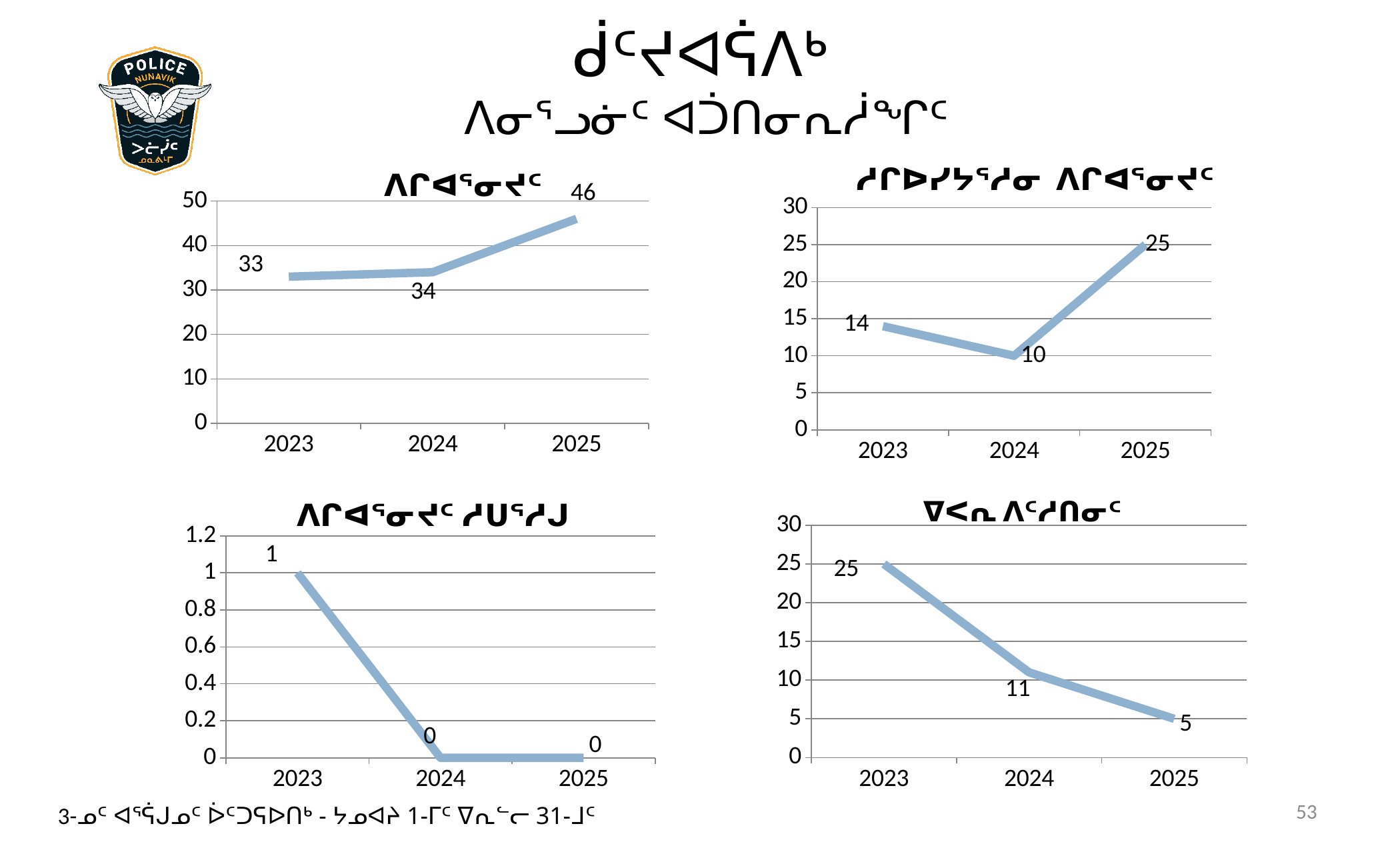
In the top-left chart, do the values rise or fall from 2023 to 2025? rise In the top-left chart, what is the value for 2025? 46 What kind of chart is the top-right chart? line chart In the top-right chart, which year has the lowest value? 2024 In the top-left chart, what is the difference between the 2025 and 2023 values? 13 In the bottom-left chart, how many years are plotted on the x axis? 3 In the bottom-left chart, what is the value for 2023? 1 In the bottom-right chart, what is the difference between the 2023 and 2025 values? 20 In the top-right chart, what is the value for 2024? 10 In the top-right chart, which year has the highest value? 2025 In the bottom-right chart, what is the value for 2024? 11 In the bottom-right chart, do the values rise or fall from 2023 to 2025? fall